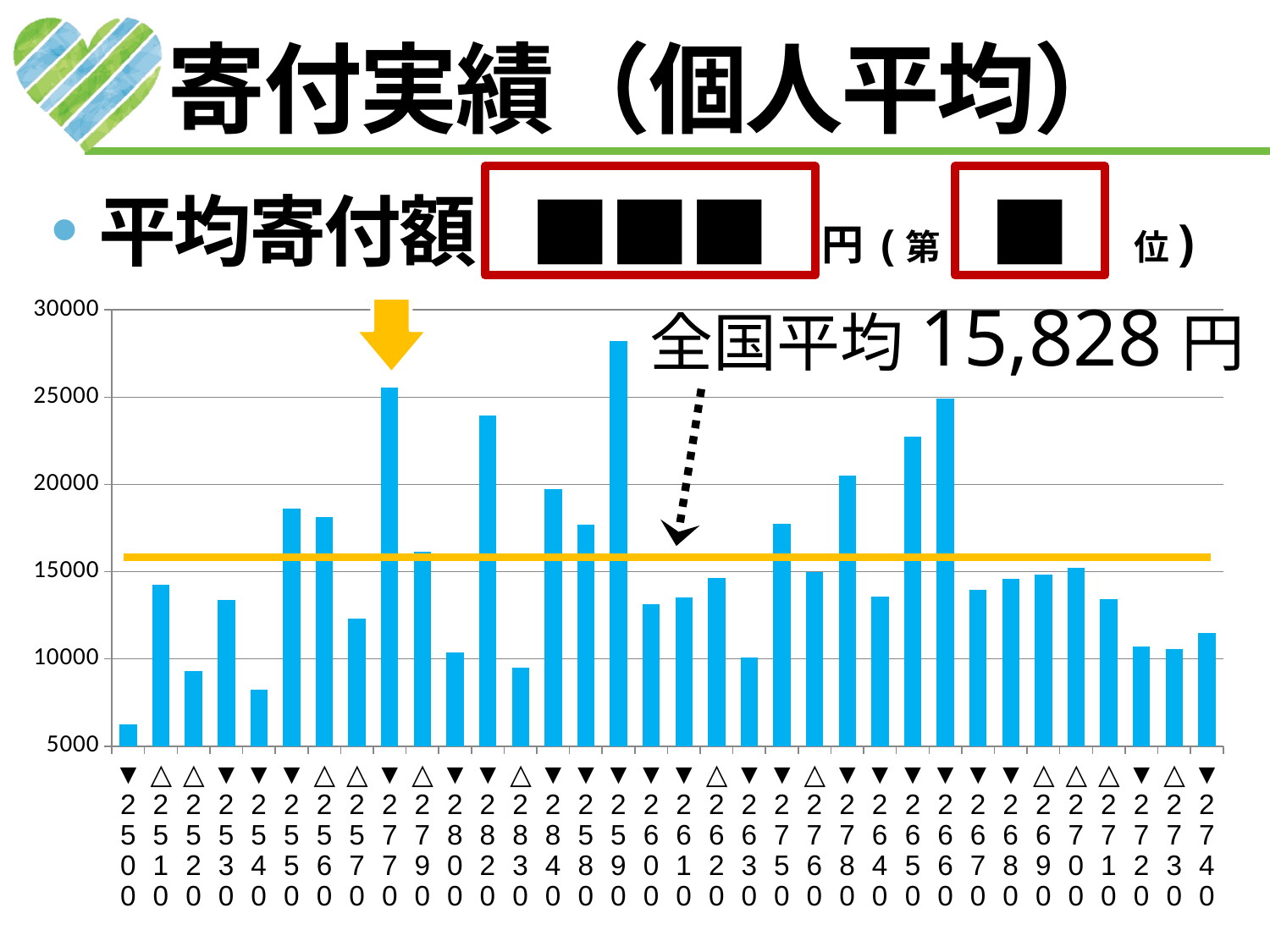
Is the value for ▼2540 greater or less than 10000? less Which has the larger value, ▼2590 or ▼2770? ▼2590 Which category has the lowest bar in the chart? ▼2500 What is the highest value shown on the vertical axis of the chart? 30000 What national average value (全国平均) is printed on the chart? 15,828 円 Is the value for ▼2500 greater or less than 10000? less Is the value for ▼2650 greater or less than 20000? greater Which category has the highest bar in the chart? ▼2590 What kind of chart is shown on the slide? bar chart How many bars are plotted in the chart? 34